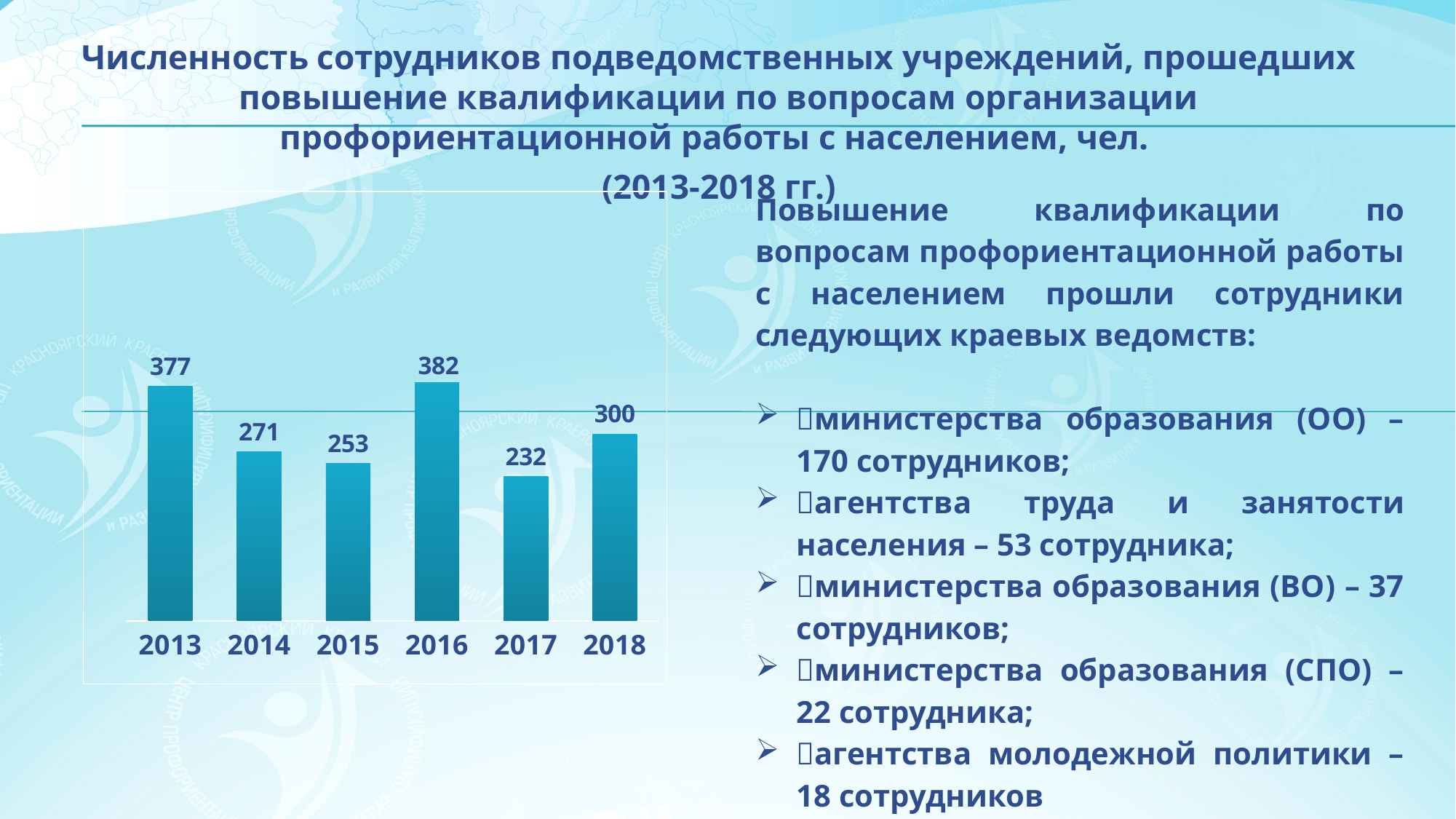
Which year has the highest value? 2016 Which year has the lowest value? 2017 What is the difference between the values for 2013 and 2014? 106 Which is larger, the value for 2015 or the value for 2018? 2018 Do the values rise or fall from 2013 to 2015? fall What is the difference between the values for 2016 and 2017? 150 What is the value for 2014? 271 How many years are shown on the x axis? 6 What is the value for 2013? 377 What kind of chart is shown on the slide? bar chart What is the value for 2018? 300 What is the value for 2016? 382